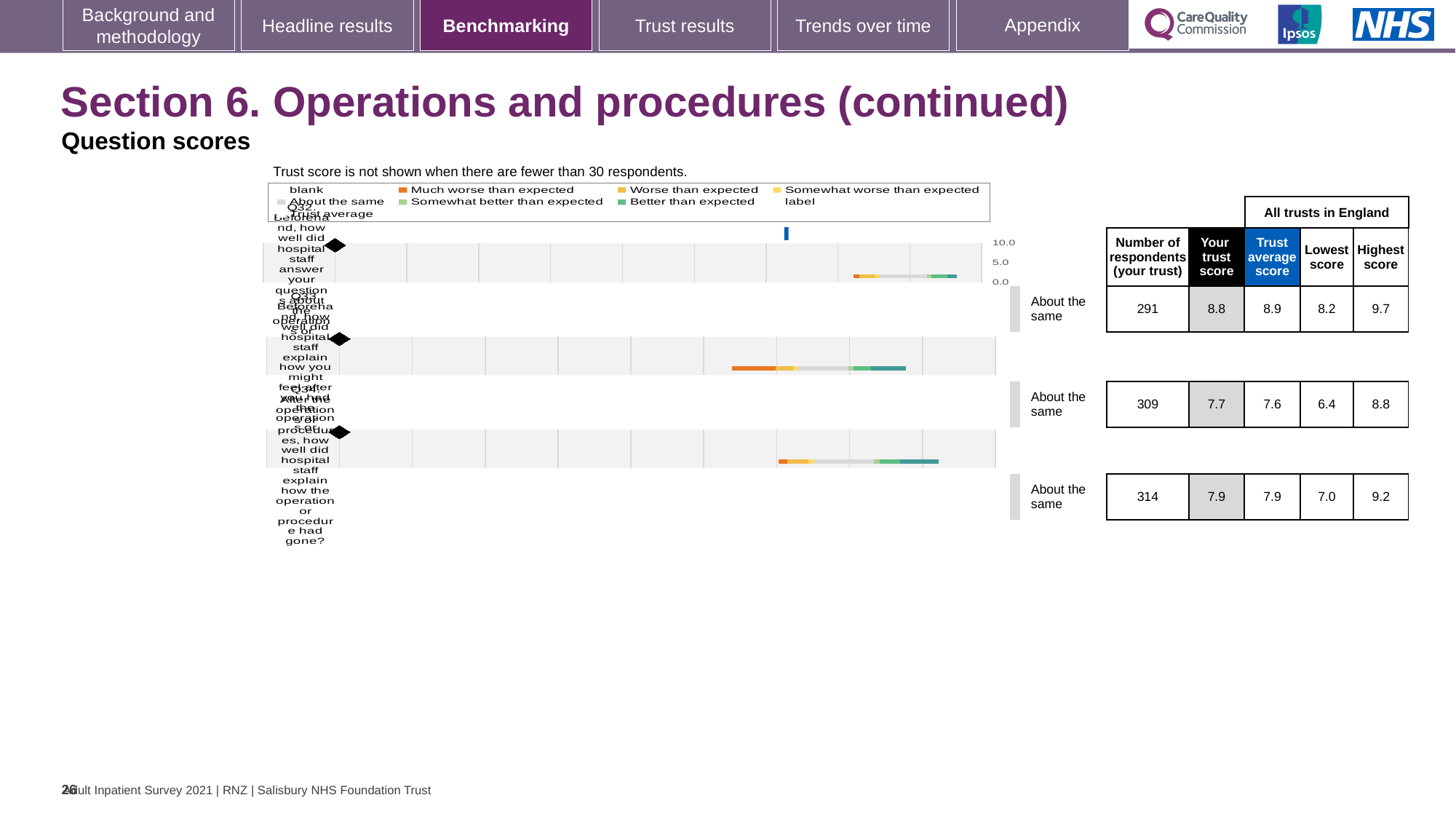
How many question charts are shown on the slide? 3 For the bottom chart, what is the highest score among all trusts in England? 9.2 Which of the three charts has the lowest 'Lowest score' value? The middle chart (6.4) For the middle chart, what is the difference between the highest score and the lowest score? 2.4 What kind of chart is used to show the question scores on this slide? bar chart For the top chart, which is larger: your trust score or the trust average score? Trust average score For the middle chart, what is the trust average score for all trusts in England? 7.6 For the top chart, what is the number of respondents for your trust? 291 Which of the three charts has the highest number of respondents? The bottom chart (314) What is the maximum value shown on the score axis of the charts? 10.0 What benchmark category is shown next to each of the three charts? About the same For the top chart, what is your trust score? 8.8